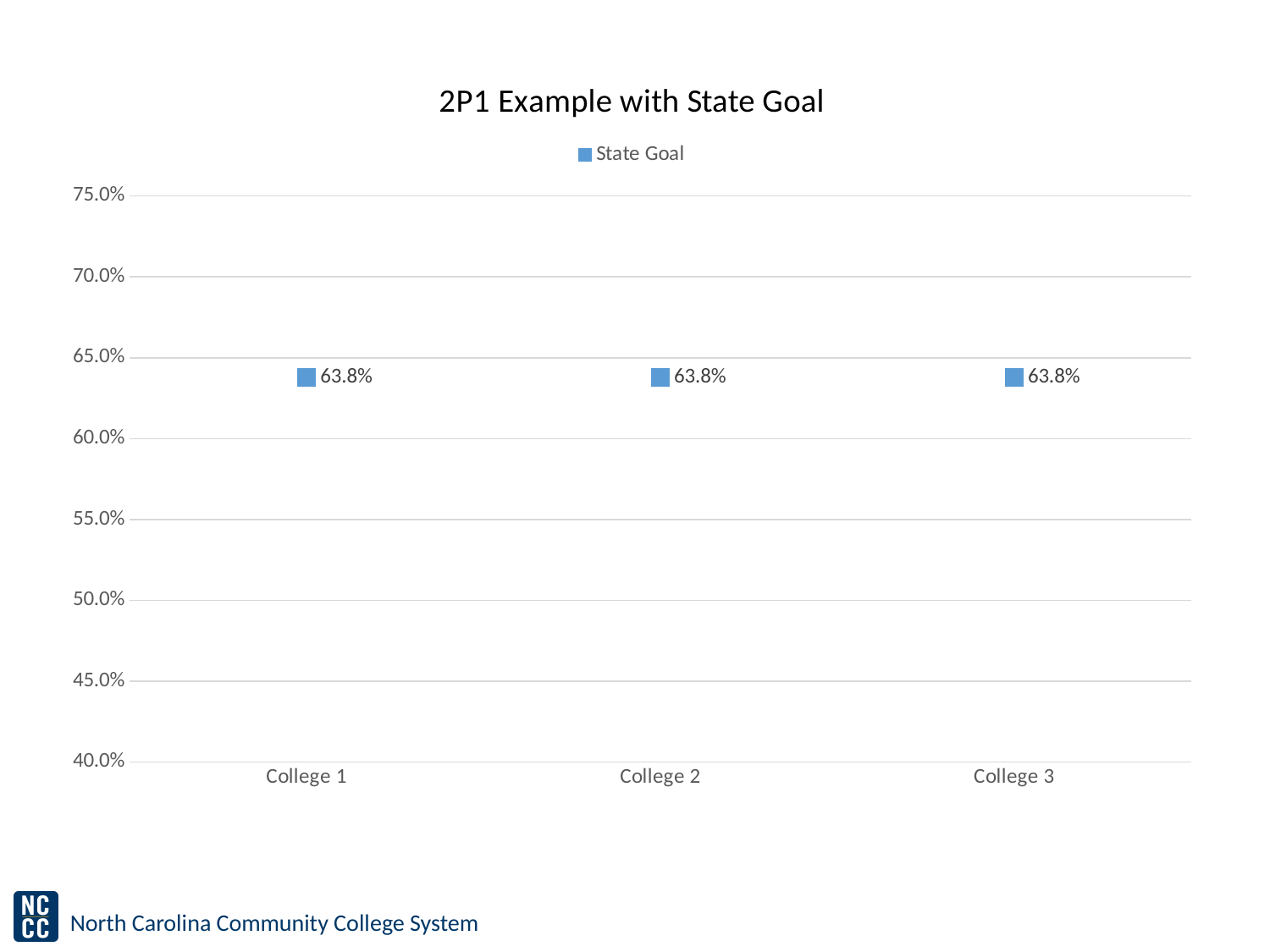
What is the title of the chart? 2P1 Example with State Goal How many colleges are shown on the x axis? 3 Is the State Goal value for College 1 greater or less than 65.0%? less How many series does the legend list? 1 What series name is shown in the legend? State Goal What is the difference between the State Goal values for College 1 and College 3? 0.0% What is the lowest value shown on the y axis? 40.0% Is the State Goal value for College 2 greater or less than 60.0%? greater Do the State Goal values rise, fall, or stay the same from College 1 to College 3? stay the same What is the State Goal value for College 2? 63.8% What is the State Goal value for College 1? 63.8% What is the State Goal value for College 3? 63.8%